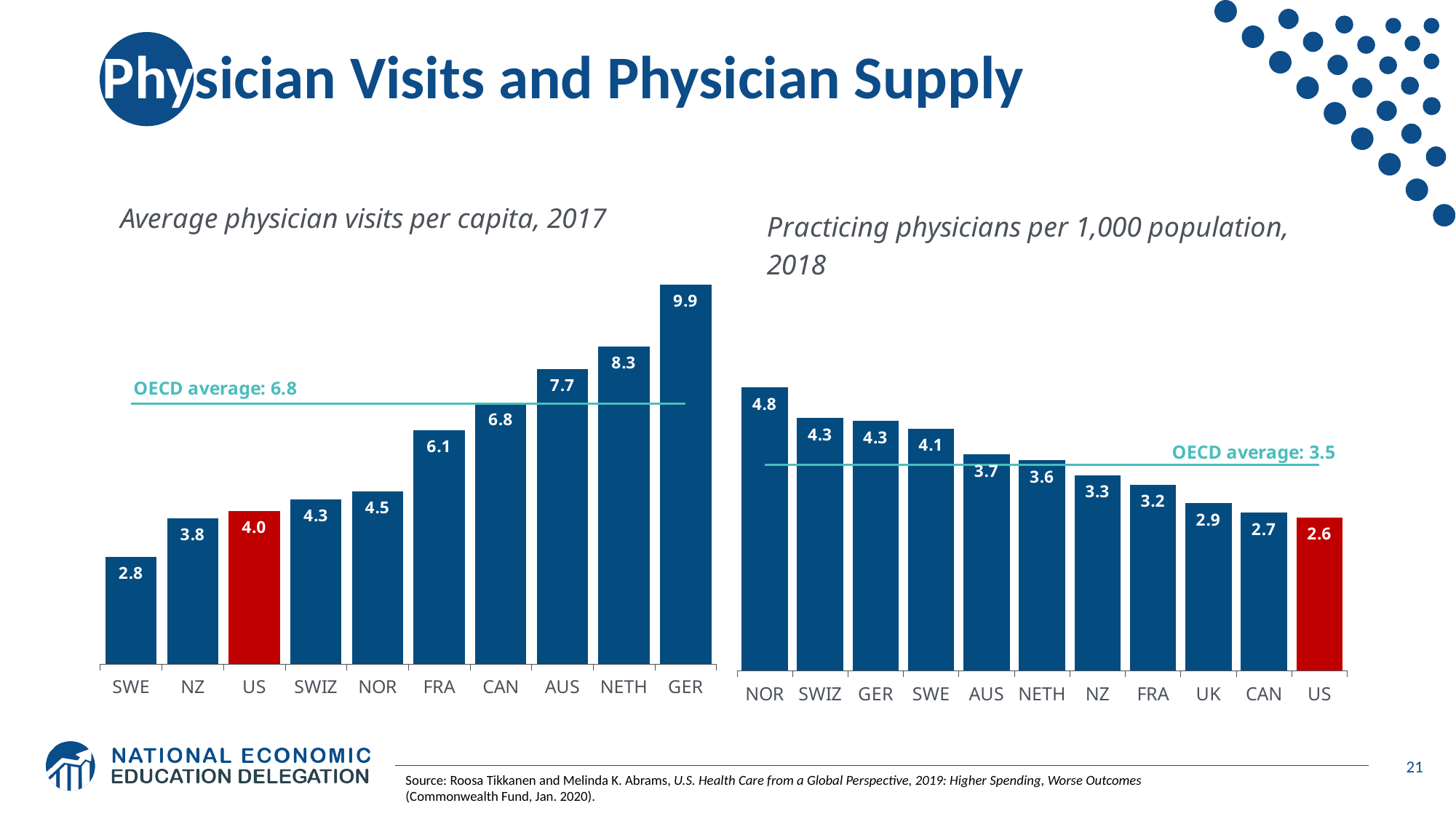
In the 'Practicing physicians per 1,000 population, 2018' chart, what is the value for NOR? 4.8 In the 'Practicing physicians per 1,000 population, 2018' chart, what OECD average is shown? 3.5 In the 'Practicing physicians per 1,000 population, 2018' chart, which country has the lowest value? US In the 'Practicing physicians per 1,000 population, 2018' chart, what is the difference between NOR and the US? 2.2 In the 'Average physician visits per capita, 2017' chart, what is the difference between GER and the US? 5.9 In the 'Practicing physicians per 1,000 population, 2018' chart, how many countries are shown? 11 In the 'Average physician visits per capita, 2017' chart, which country has the highest value? GER In the 'Average physician visits per capita, 2017' chart, how many countries are shown? 10 In the 'Practicing physicians per 1,000 population, 2018' chart, which is larger, the value for SWE or the value for FRA? SWE In the 'Average physician visits per capita, 2017' chart, which country has the lowest value? SWE What kind of chart is the 'Average physician visits per capita, 2017' chart? Bar chart In the 'Average physician visits per capita, 2017' chart, what is the value for the US? 4.0